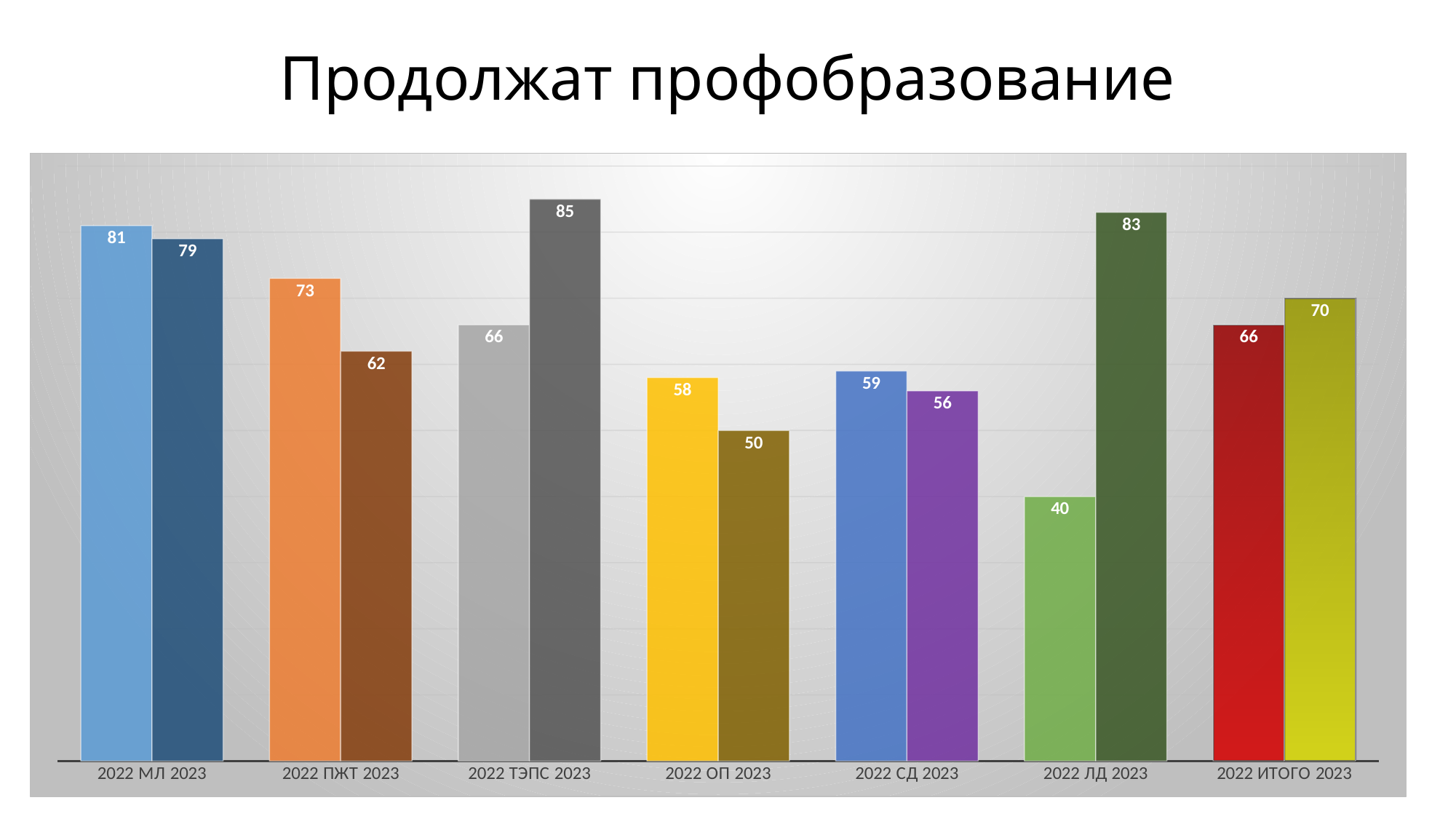
Which group has the highest 2023 value? ТЭПС What is the 2023 value for ТЭПС? 85 What is the 2022 value for ЛД? 40 Which is larger for ОП, the 2022 value or the 2023 value? 2022 What is the title of the slide? Продолжат профобразование What is the 2022 value for МЛ? 81 What is the difference between the 2022 and 2023 values for ПЖТ? 11 What is the 2023 value for ИТОГО? 70 How many category groups are shown on the x axis? 7 What is the difference between the 2023 and 2022 values for ЛД? 43 Which group has the lowest 2022 value? ЛД What kind of chart is shown on the slide? Bar chart